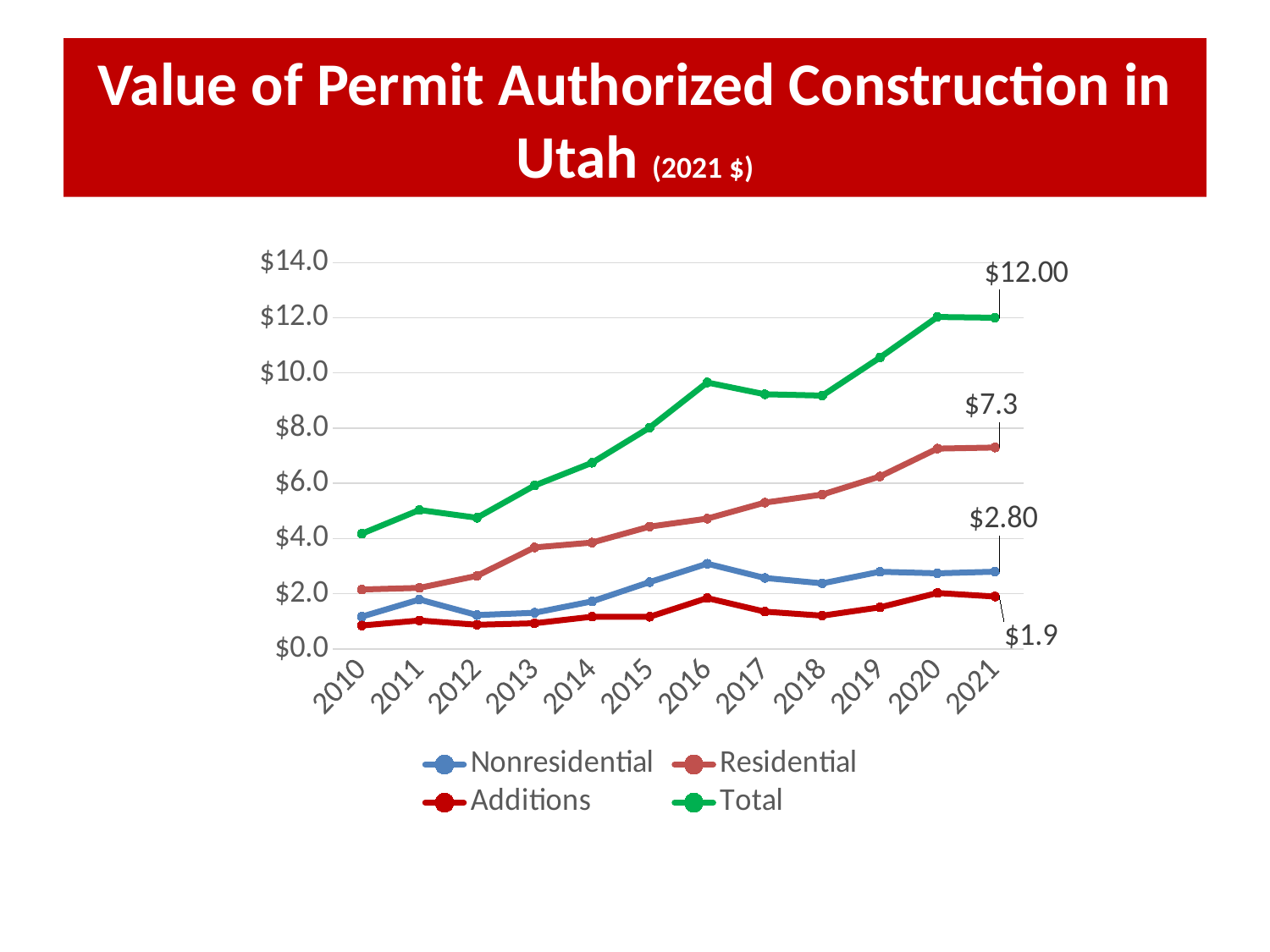
Is the value of the Total series in 2016 greater or less than $8.0? greater How many years are shown on the x axis? 12 What is the value of the Additions series in 2021? $1.9 How many series does the legend list? 4 Which series has the lowest value in 2021? Additions What kind of chart is shown on the slide? line chart What is the value of the Nonresidential series in 2021? $2.80 Which series has the highest value in 2021? Total Is the value of the Residential series in 2010 greater or less than $4.0? less What is the value of the Residential series in 2021? $7.3 What is the value of the Total series in 2021? $12.00 In 2021, which is larger: the Residential value or the Nonresidential value? Residential